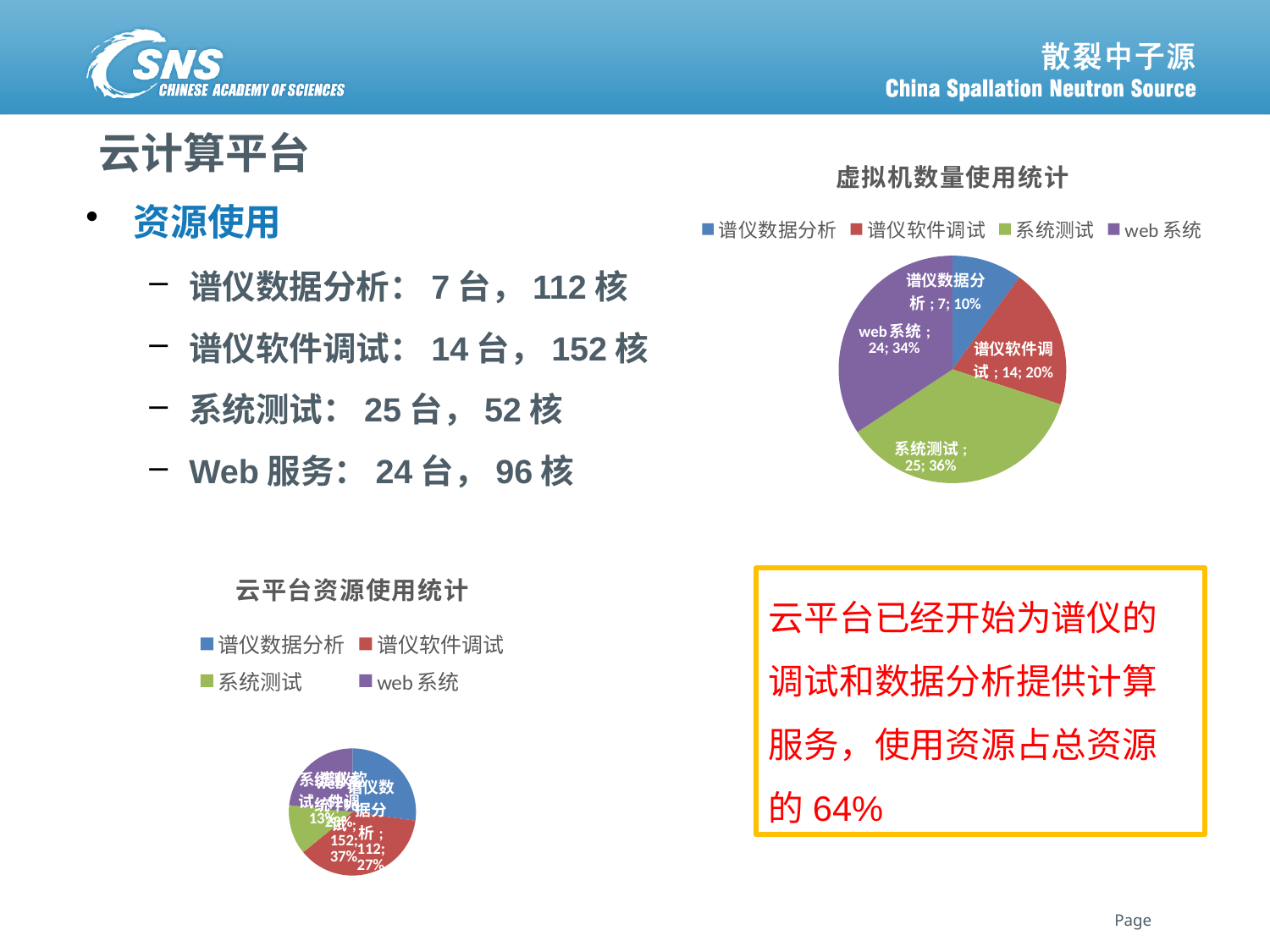
In the chart titled 虚拟机数量使用统计, which category has the smallest slice? 谱仪数据分析 In the chart titled 虚拟机数量使用统计, what share of the pie does 谱仪软件调试 take? 20% In the chart titled 虚拟机数量使用统计, what share of the pie does web 系统 take? 34% In the chart titled 云平台资源使用统计, what kind of chart is shown? pie chart In the chart titled 虚拟机数量使用统计, how many slices does the pie have? 4 In the chart titled 虚拟机数量使用统计, how many entries does the legend list? 4 In the chart titled 虚拟机数量使用统计, what kind of chart is shown? pie chart In the chart titled 虚拟机数量使用统计, what is the difference between the values for 谱仪软件调试 and 谱仪数据分析? 7 In the chart titled 虚拟机数量使用统计, which is larger, the value for web 系统 or the value for 谱仪软件调试? web 系统 In the chart titled 虚拟机数量使用统计, what is the value for 系统测试? 25 In the chart titled 虚拟机数量使用统计, which category has the largest slice? 系统测试 In the chart titled 虚拟机数量使用统计, what is the value for 谱仪数据分析? 7